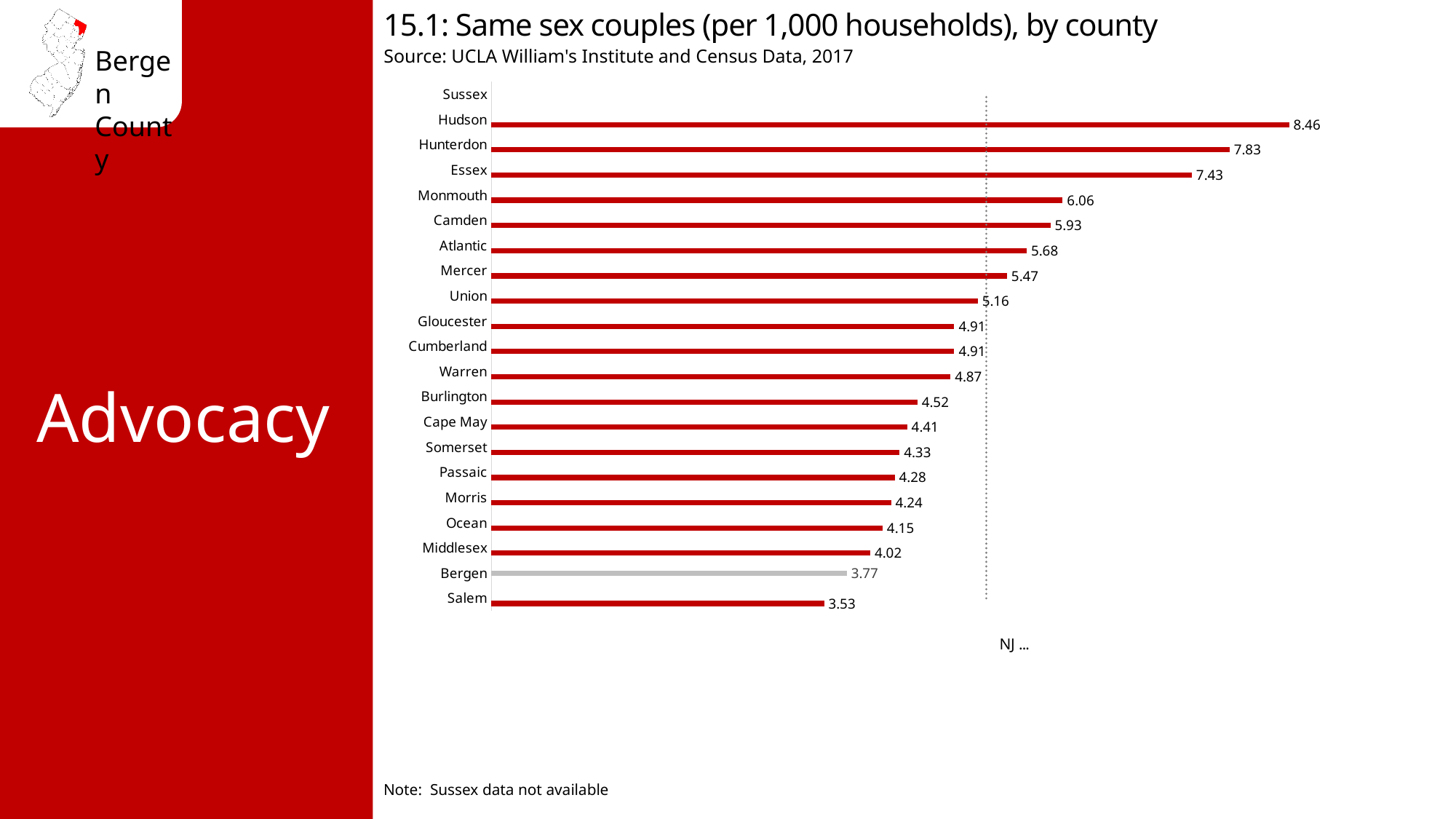
Which is larger, the value for Camden or the value for Atlantic? Camden What is the value for Hudson? 8.46 What kind of chart is this? Bar chart What is the value for Bergen? 3.77 Which county has the lowest plotted value? Salem How many counties are listed on the y axis? 21 What is the difference between the values for Essex and Monmouth? 1.37 What is the value for Mercer? 5.47 Which is larger, the value for Middlesex or the value for Ocean? Ocean What is the difference between the values for Hudson and Bergen? 4.69 Which county's bar is shown in grey instead of red? Bergen Which county has the highest value? Hudson